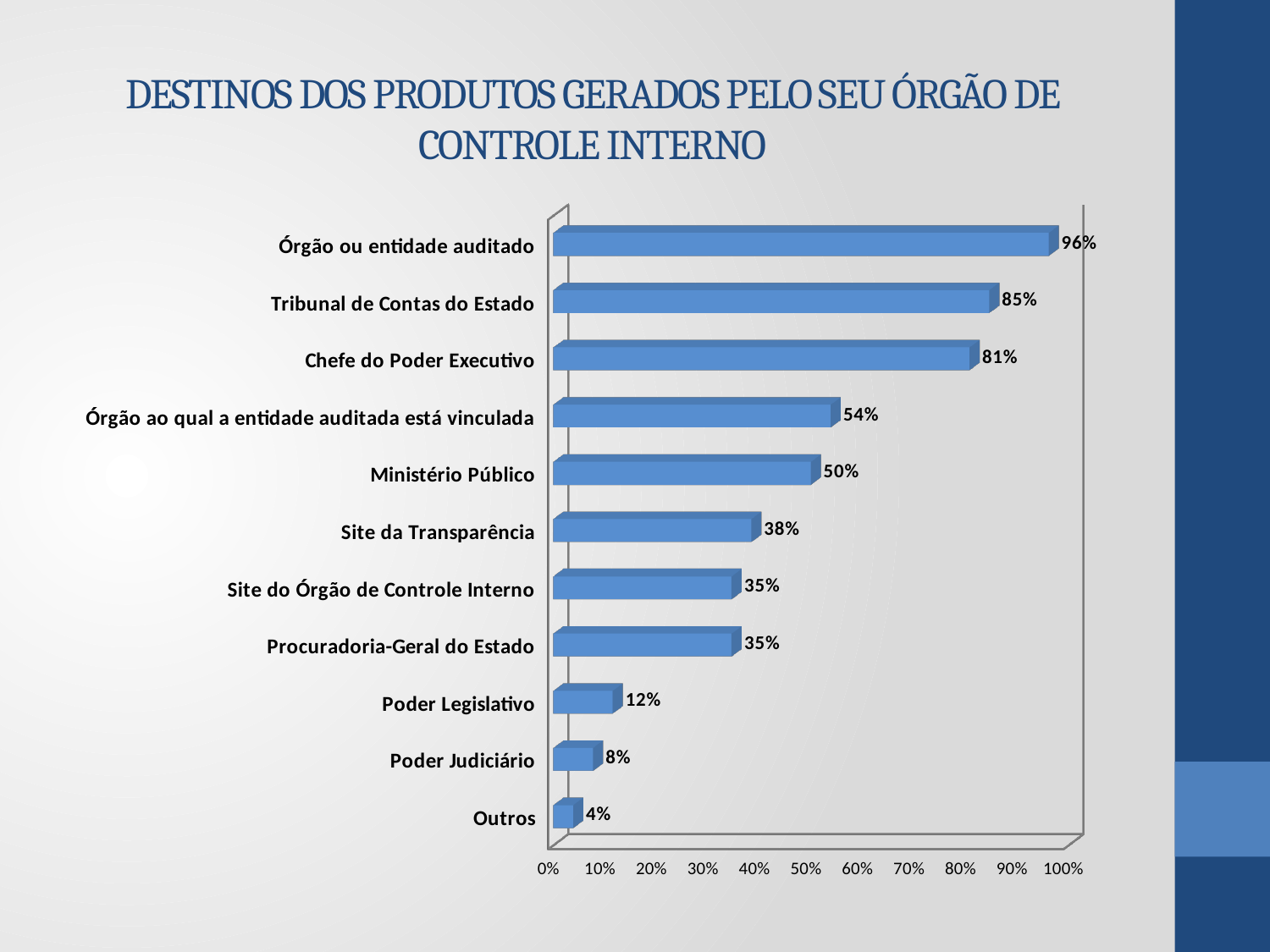
What is the value for Poder Legislativo? 12% Is the value for Poder Judiciário greater or less than 10%? less What is the title of the slide? DESTINOS DOS PRODUTOS GERADOS PELO SEU ÓRGÃO DE CONTROLE INTERNO Which category has the lowest value? Outros Which category has the highest value? Órgão ou entidade auditado What kind of chart is shown on the slide? bar chart What is the difference between the values for Órgão ou entidade auditado and Outros? 92% How many categories are shown in the chart? 11 What is the value for Ministério Público? 50% What is the value for Tribunal de Contas do Estado? 85% Which is larger, the value for Órgão ao qual a entidade auditada está vinculada or the value for Ministério Público? Órgão ao qual a entidade auditada está vinculada What is the difference between the values for Chefe do Poder Executivo and Site da Transparência? 43%